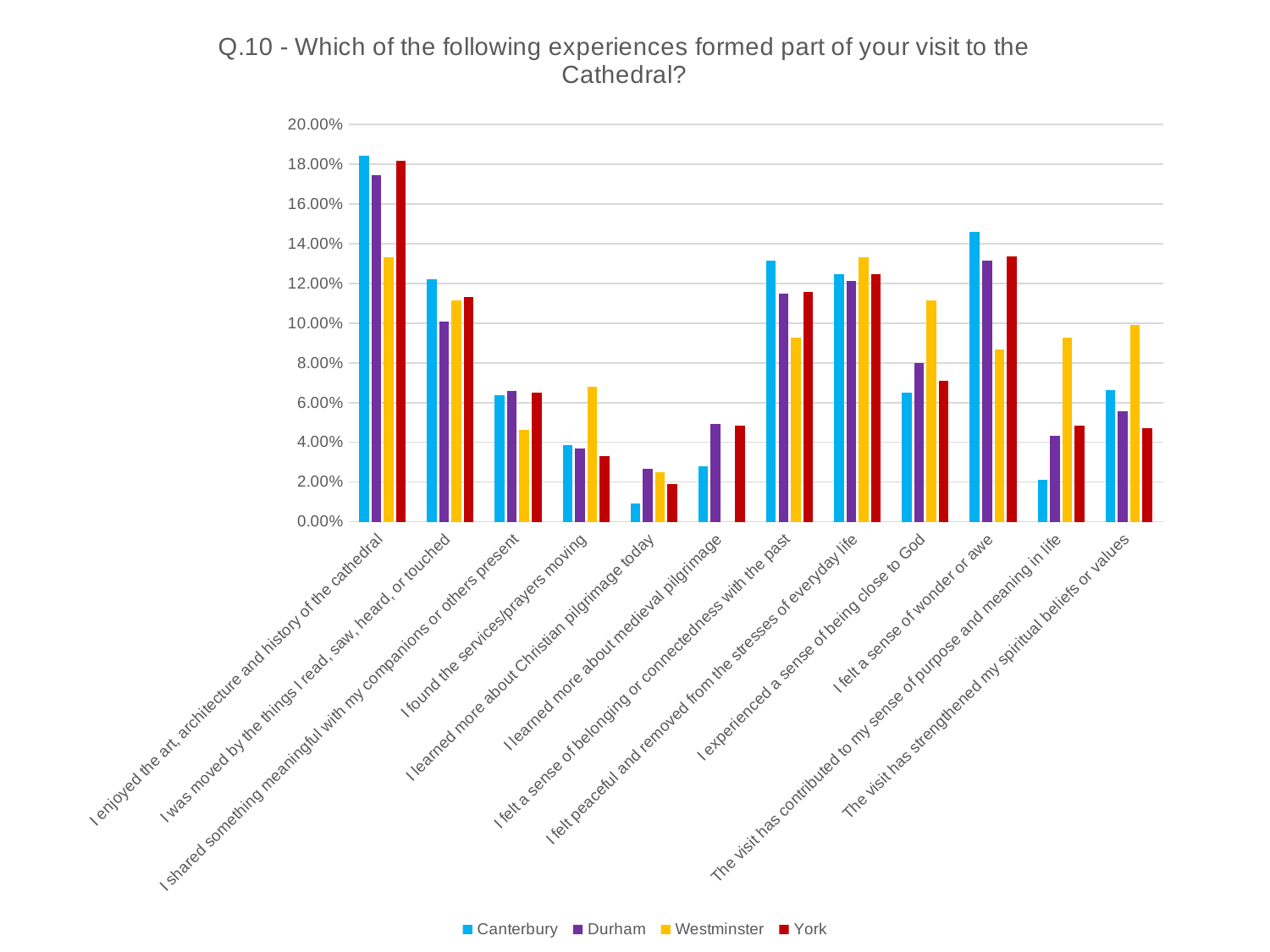
Is the Canterbury value for 'I felt a sense of wonder or awe' greater or less than 12.00%? greater Is the Westminster value for 'I experienced a sense of being close to God' greater or less than 10.00%? greater Which category has the highest value for Canterbury? I enjoyed the art, architecture and history of the cathedral What colour represents York in the legend? Red How many experience categories are shown along the x axis? 12 Is the York value for 'I found the services/prayers moving' greater or less than 4.00%? less Which cathedral has the highest value for 'I found the services/prayers moving'? Westminster Which category has the lowest value for Canterbury? I learned more about Christian pilgrimage today How many series does the legend list? 4 For 'I felt a sense of wonder or awe', which is larger: Canterbury or Westminster? Canterbury What kind of chart is shown on the slide? Bar chart For 'The visit has contributed to my sense of purpose and meaning in life', which is larger: Westminster or Canterbury? Westminster